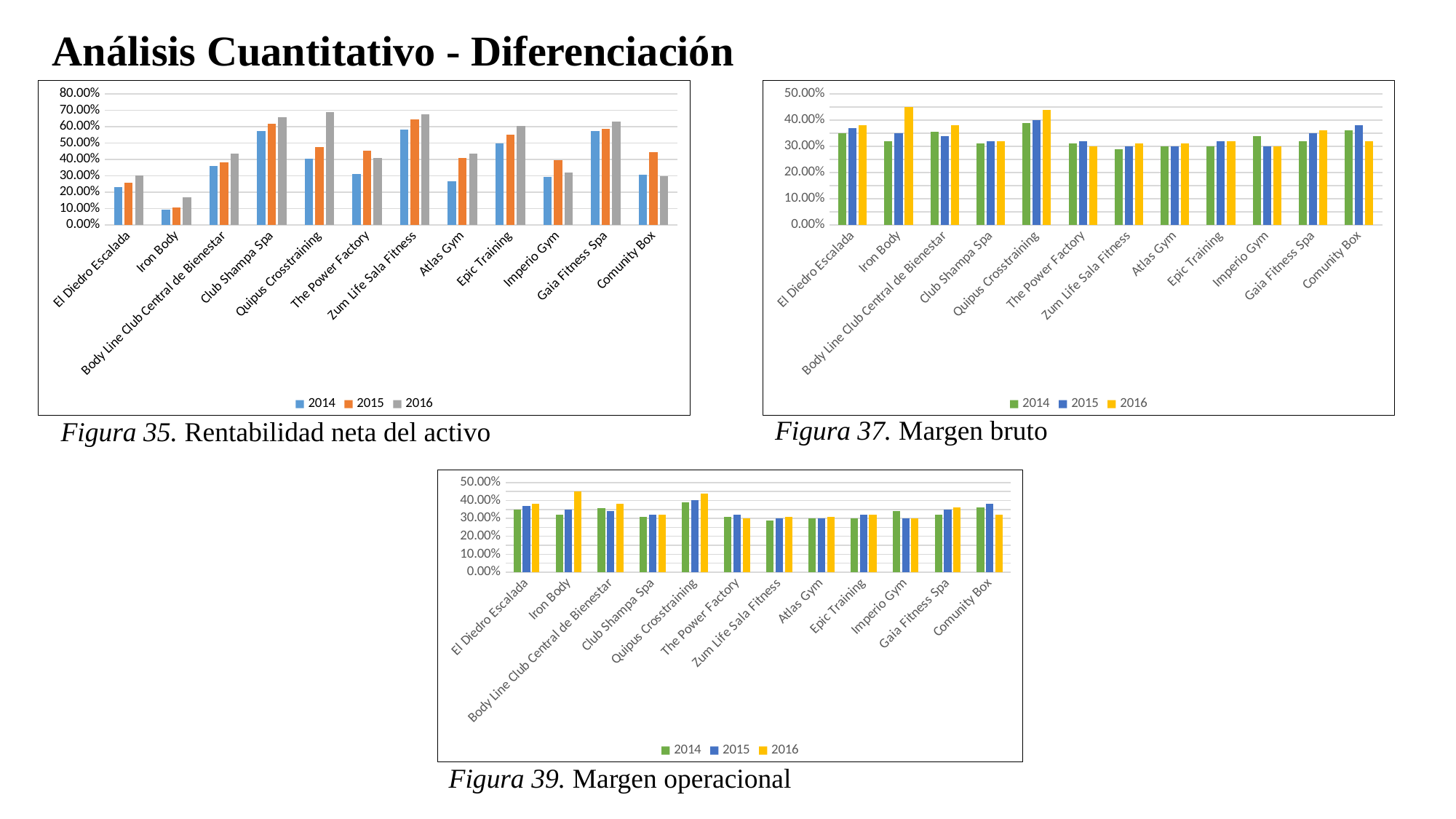
In the chart titled Figura 37. Margen bruto, is the 2016 value for Iron Body greater or less than 40.00%? greater What kind of chart is the chart titled Figura 39. Margen operacional? bar chart In the chart titled Figura 35. Rentabilidad neta del activo, which is larger for Imperio Gym: the 2015 value or the 2016 value? 2015 How many series does the legend list in the chart titled Figura 37. Margen bruto? 3 In the chart titled Figura 35. Rentabilidad neta del activo, is the 2016 value for Quipus Crosstraining greater or less than 60.00%? greater In the chart titled Figura 35. Rentabilidad neta del activo, which category has the lowest values across all three years? Iron Body In the chart titled Figura 39. Margen operacional, which is larger for Iron Body: the 2014 value or the 2016 value? 2016 In the chart titled Figura 35. Rentabilidad neta del activo, is the 2014 value for Club Shampa Spa greater or less than 50.00%? greater In the chart titled Figura 35. Rentabilidad neta del activo, which is larger for Quipus Crosstraining: the 2014 value or the 2016 value? 2016 How many categories are shown on the x axis of the chart titled Figura 37. Margen bruto? 12